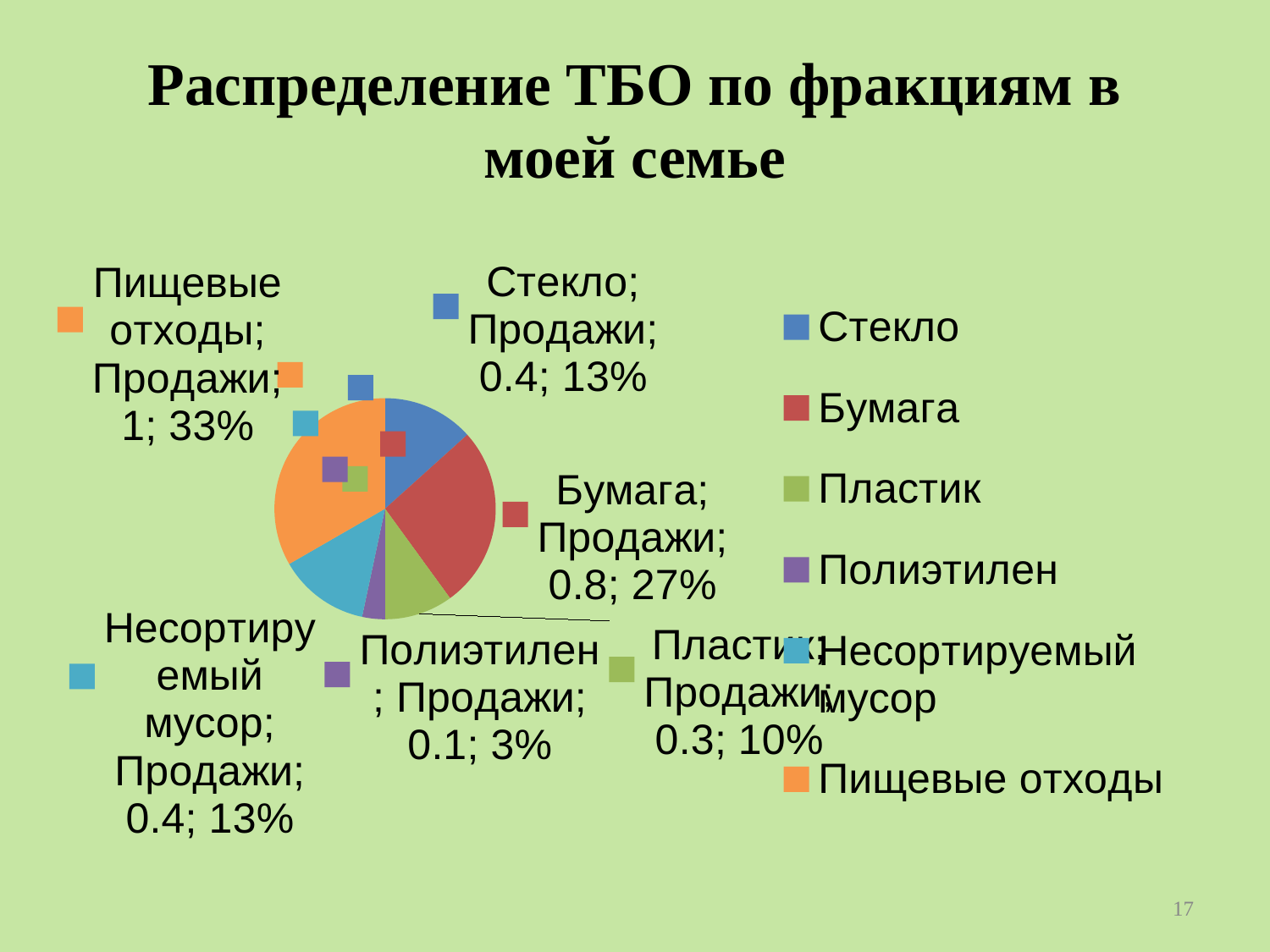
What colour is the slice for Бумага? red What is the difference between the values for Бумага and Стекло? 0.4 Which is larger, the value for Пластик or the value for Несортируемый мусор? Несортируемый мусор What share of the pie does Пищевые отходы take? 33% What share of the pie does Пластик take? 10% What is the title of the chart? Распределение ТБО по фракциям в моей семье Which category has the smallest slice of the pie? Полиэтилен What kind of chart is shown on the slide? pie chart Which category has the largest slice of the pie? Пищевые отходы What is the value for Полиэтилен? 0.1 What is the value for Бумага? 0.8 How many categories does the pie chart have? 6